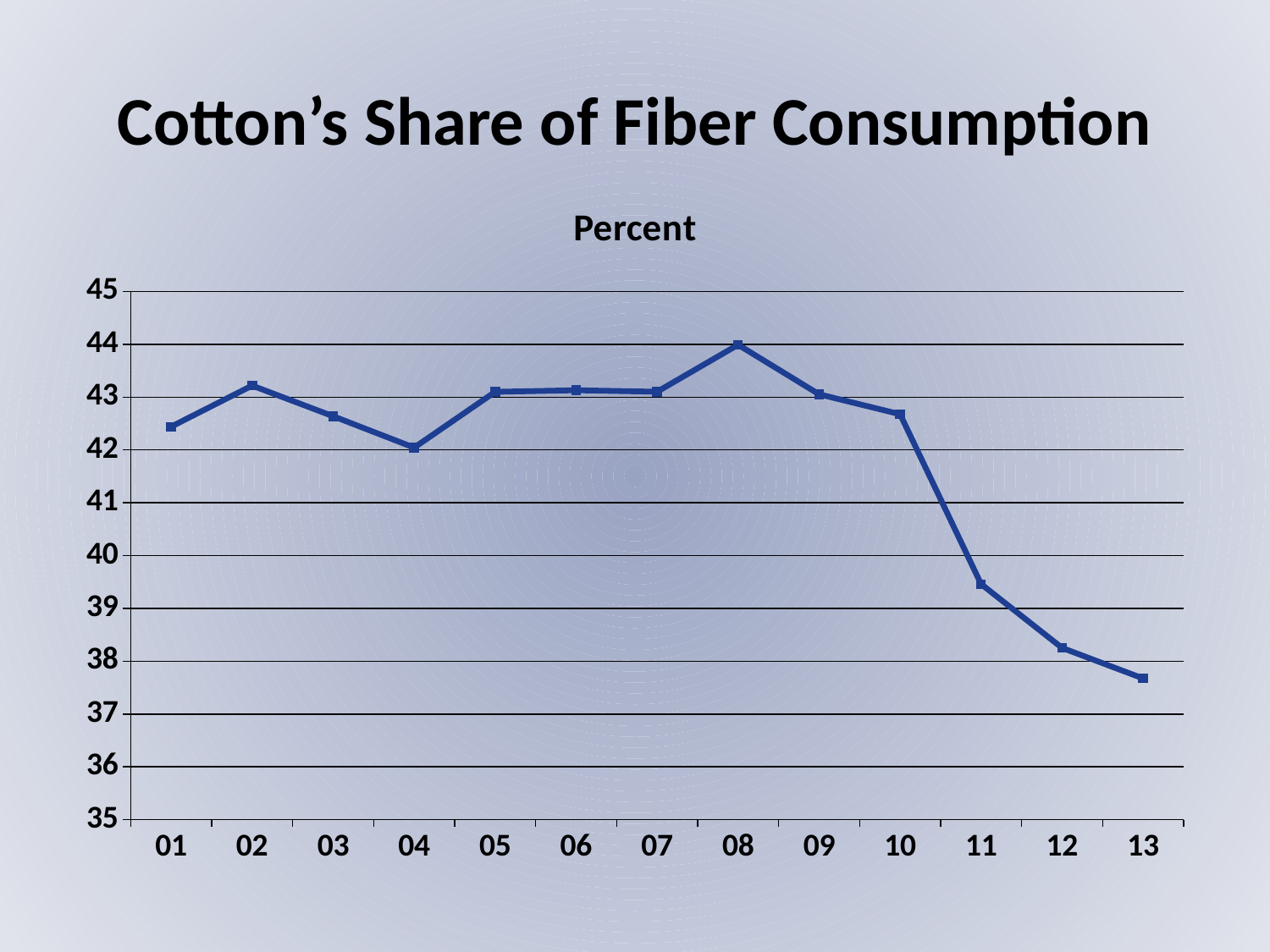
In which year is cotton's share of fiber consumption highest? 08 Is the value for 11 greater or less than 40? less What is the title of the chart on the slide? Cotton's Share of Fiber Consumption Do the values rise or fall from 10 to 13? fall What unit label appears above the chart's plot area? Percent Which year has the larger value, 02 or 04? 02 In which year is cotton's share of fiber consumption lowest? 13 Is the value for 10 greater or less than 42? greater Is the value for 13 greater or less than 38? less What kind of chart is shown on the slide? line chart How many years are plotted along the x axis? 13